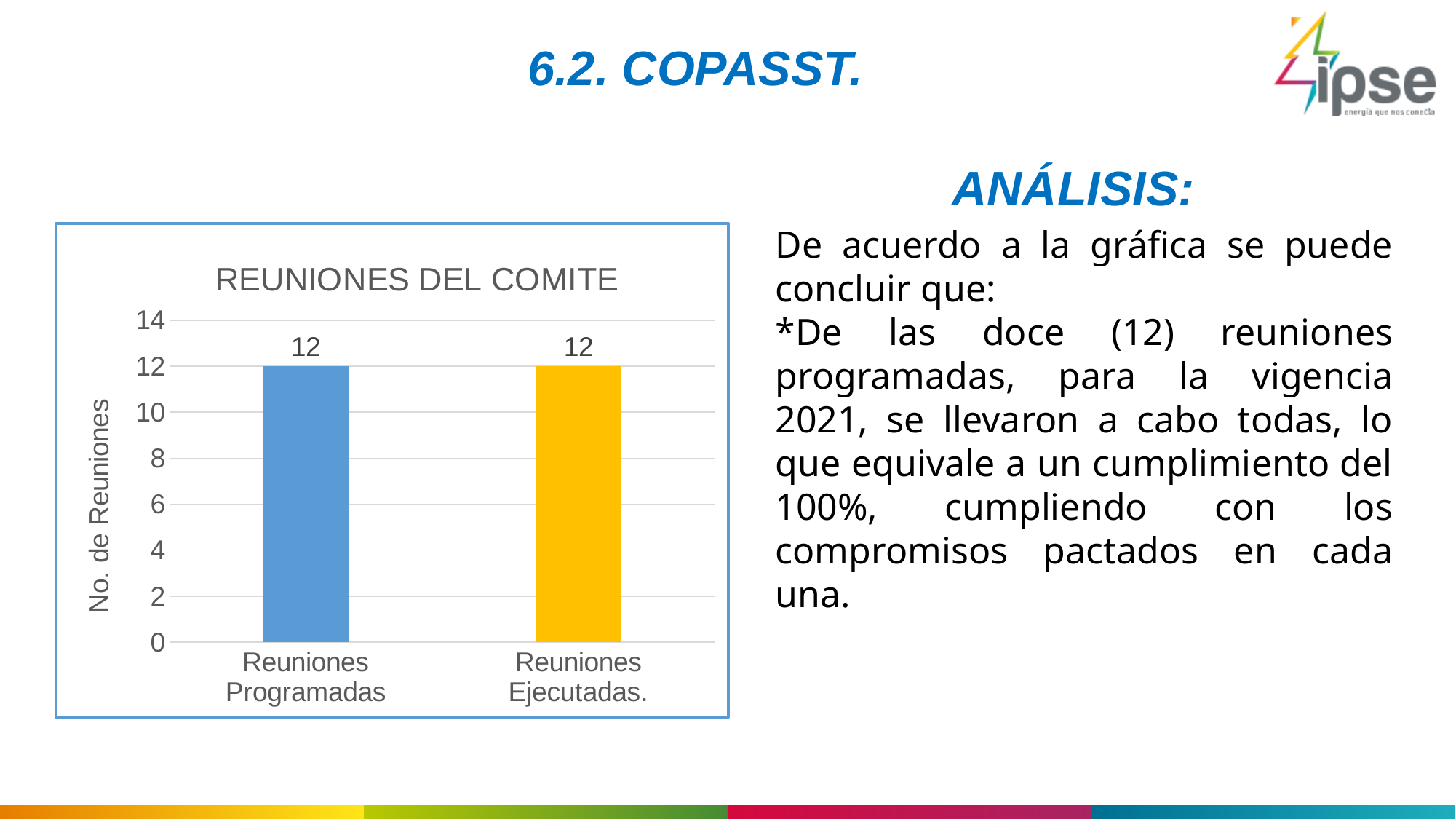
What kind of chart is shown? bar chart Is the value for Reuniones Ejecutadas greater or less than 10? greater What is the label of the vertical axis? No. de Reuniones How many categories are shown on the x axis? 2 What is the highest value shown on the vertical axis? 14 Is the value for Reuniones Programadas greater or less than 14? less What is the difference between Reuniones Programadas and Reuniones Ejecutadas? 0 What is the value for Reuniones Programadas? 12 What is the value for Reuniones Ejecutadas? 12 What is the title of the chart? REUNIONES DEL COMITE